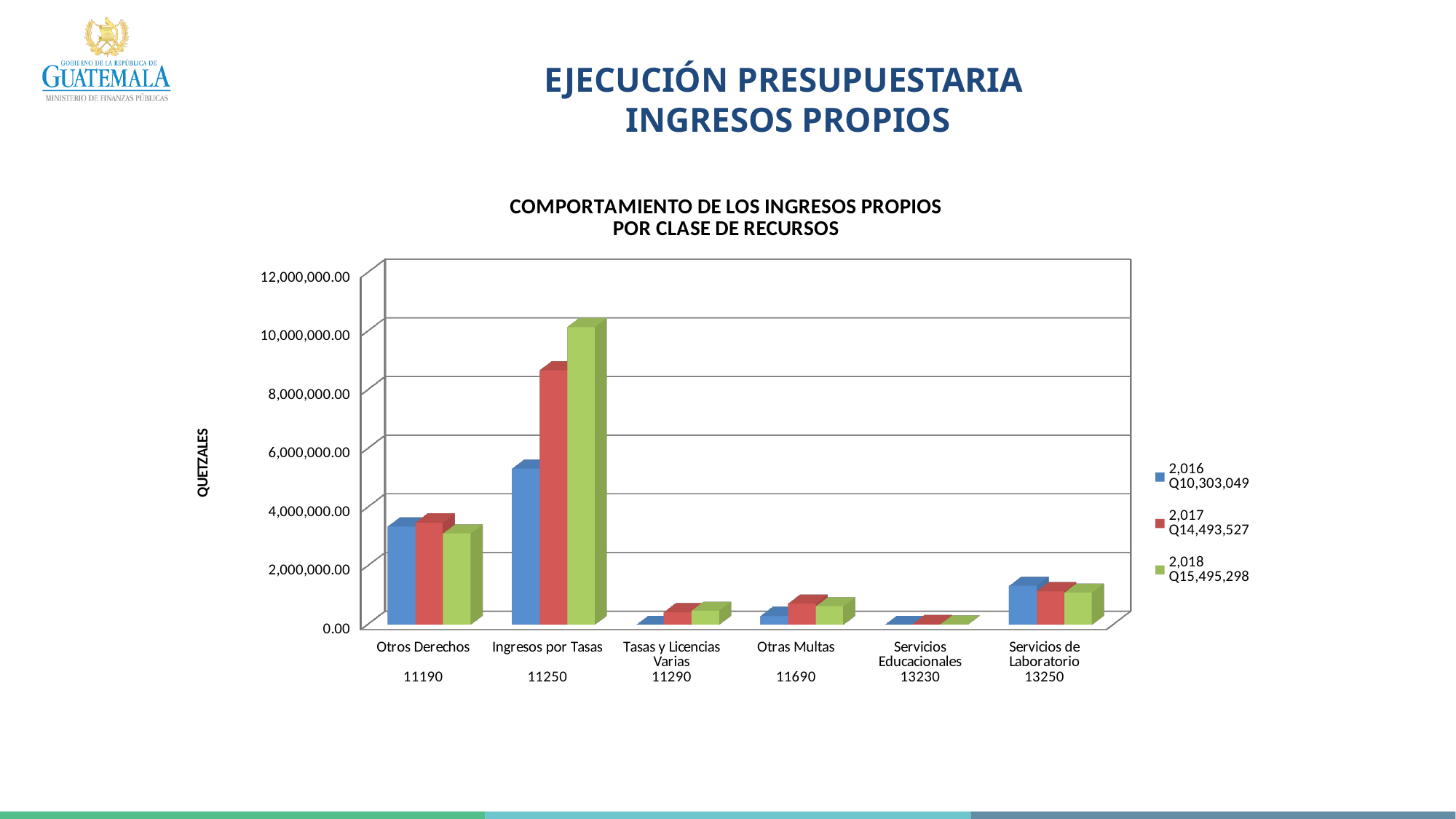
Is the value for Ingresos por Tasas in 2,018 greater or less than 8,000,000.00? greater Which category has the lowest bars in the chart? Servicios Educacionales Is the value for Ingresos por Tasas in 2,016 greater or less than 4,000,000.00? greater Is the value for Otros Derechos in 2,017 greater or less than 4,000,000.00? less Which category has the highest bars in the chart? Ingresos por Tasas How many categories are shown on the x axis of the chart? 6 For Ingresos por Tasas, do the values rise or fall from 2,016 to 2,018? rise How many series does the legend list? 3 What total amount does the legend show for the 2,017 series? Q14,493,527 What kind of chart is shown on the slide? Bar chart For Ingresos por Tasas, which is larger: the 2,016 value or the 2,017 value? 2,017